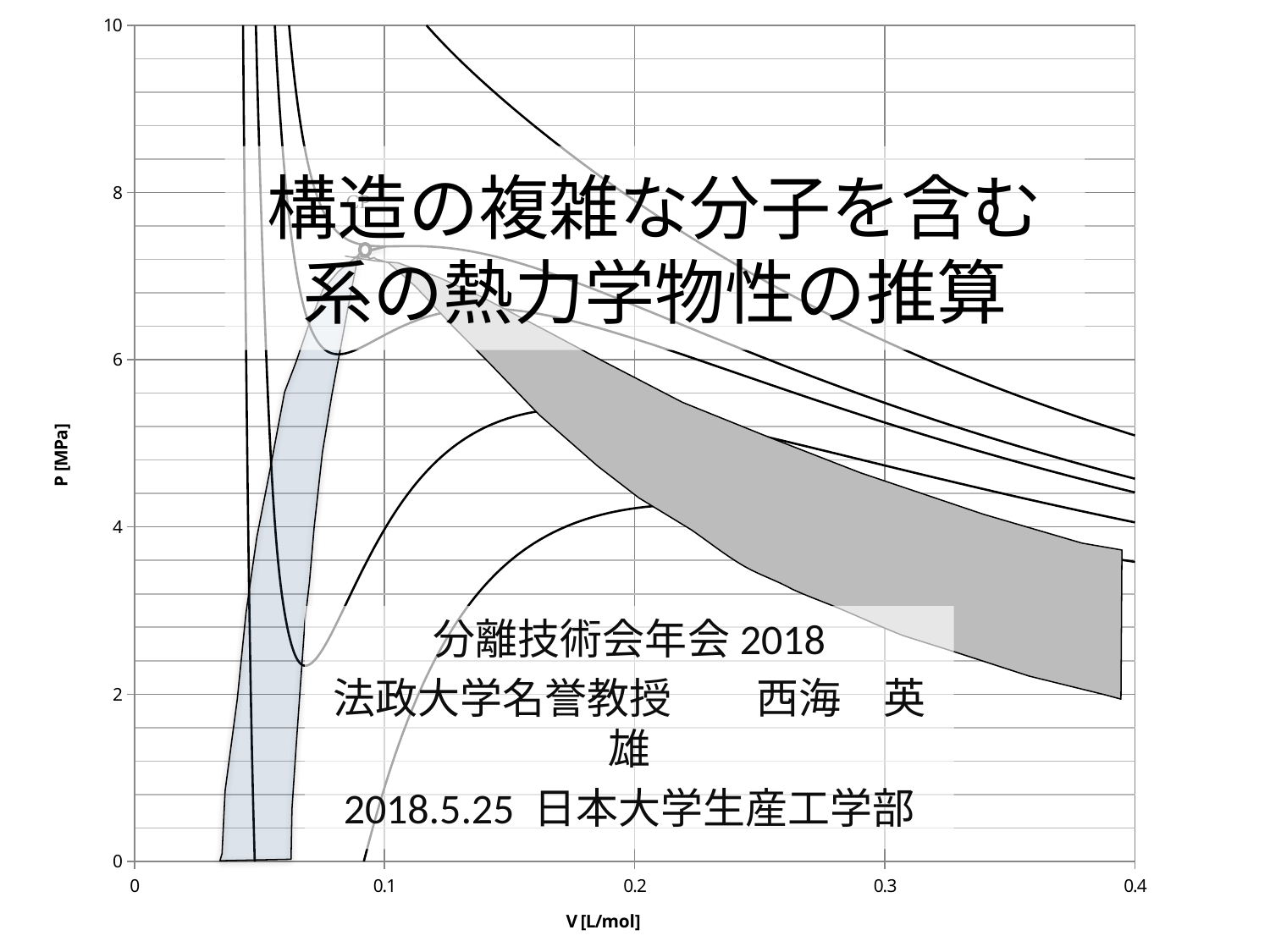
What is the label of the horizontal axis of the chart? V [L/mol] At V = 0.4 L/mol, is the pressure of the lowest plotted curve greater or less than 2 MPa? greater What is the label of the vertical axis of the chart? P [MPa] At V = 0.4 L/mol, is the pressure of the highest plotted curve greater or less than 8 MPa? less What kind of chart is shown on the slide? line chart